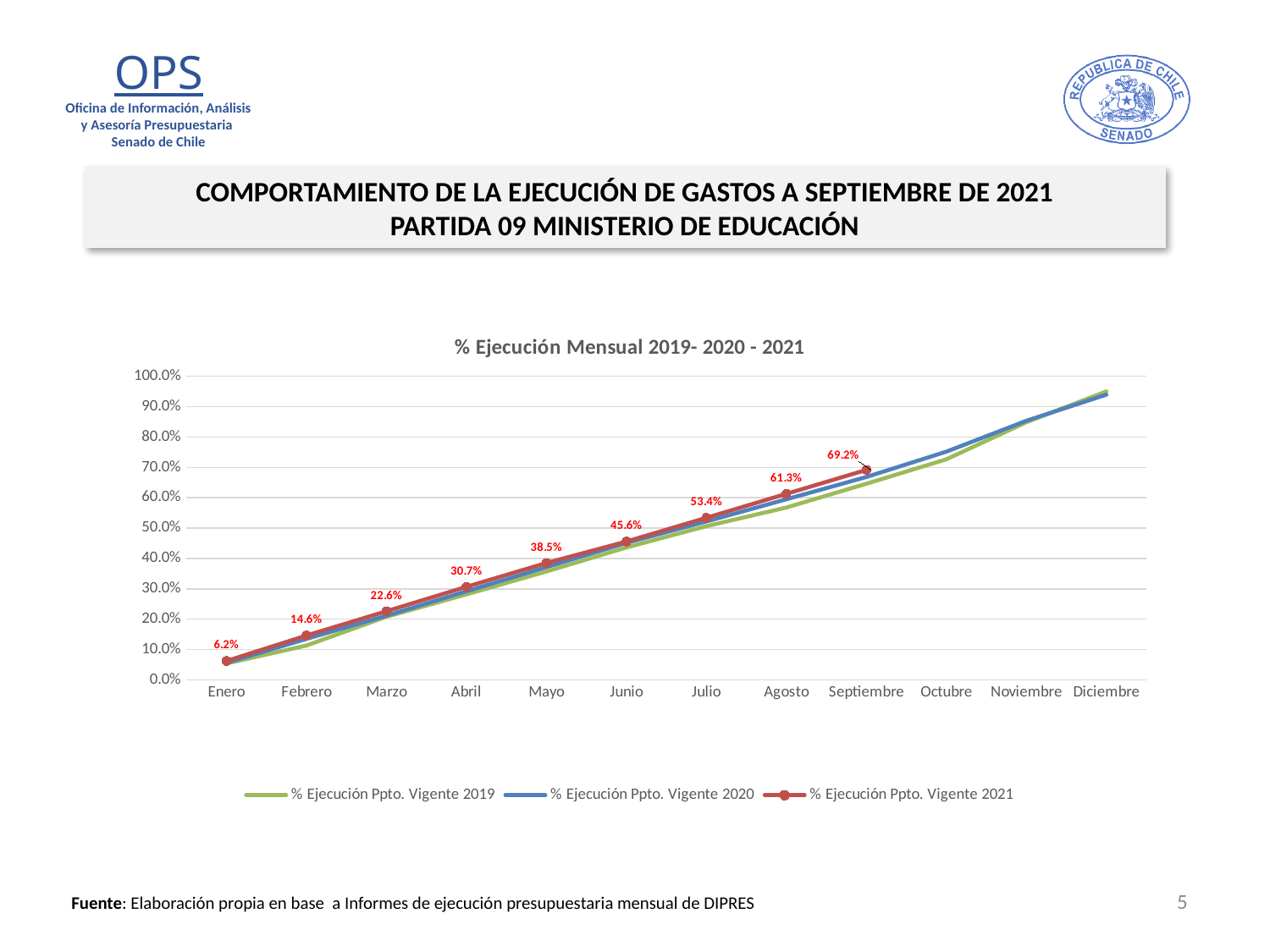
How many months are shown on the x axis? 12 Which month has the highest labelled value for % Ejecución Ppto. Vigente 2021? Septiembre What is the title of the chart? % Ejecución Mensual 2019- 2020 - 2021 What kind of chart is shown on the slide? Line chart What is the value of % Ejecución Ppto. Vigente 2021 for Mayo? 38.5% What is the value of % Ejecución Ppto. Vigente 2021 for Enero? 6.2% What is the value of % Ejecución Ppto. Vigente 2021 for Septiembre? 69.2% Do the values of the series rise or fall from Enero to Diciembre? Rise How many series does the legend list? 3 What is the difference between the 2021 values for Febrero and Enero? 8.4% By how much did % Ejecución Ppto. Vigente 2021 increase from Agosto to Septiembre? 7.9% Is the value for % Ejecución Ppto. Vigente 2020 in Diciembre greater or less than 90.0%? greater